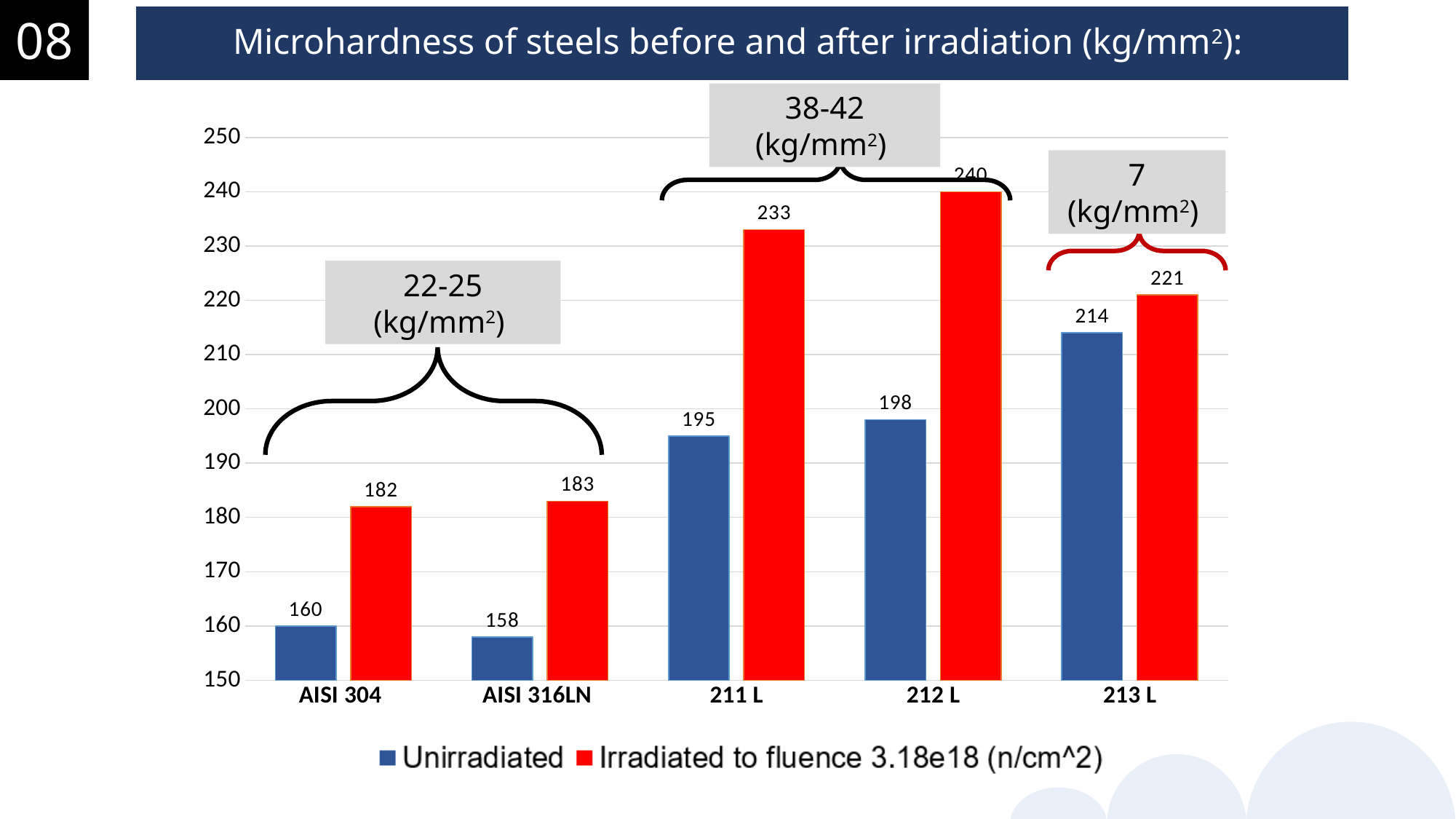
Which is larger: the irradiated value for AISI 316LN or the unirradiated value for 211 L? Unirradiated value for 211 L How many steel categories are shown on the x axis? 5 What is the unirradiated microhardness value for AISI 304? 160 Is the irradiated value for 213 L greater or less than 220? greater What is the difference between the irradiated and unirradiated microhardness for 211 L? 38 What kind of chart is shown on the slide? Bar chart How many series does the legend list? 2 Which steel has the lowest unirradiated microhardness? AISI 316LN Which steel has the highest irradiated microhardness? 212 L What is the irradiated microhardness value for 212 L? 240 What colour represents the irradiated series in the chart? Red What is the unirradiated microhardness value for 213 L? 214